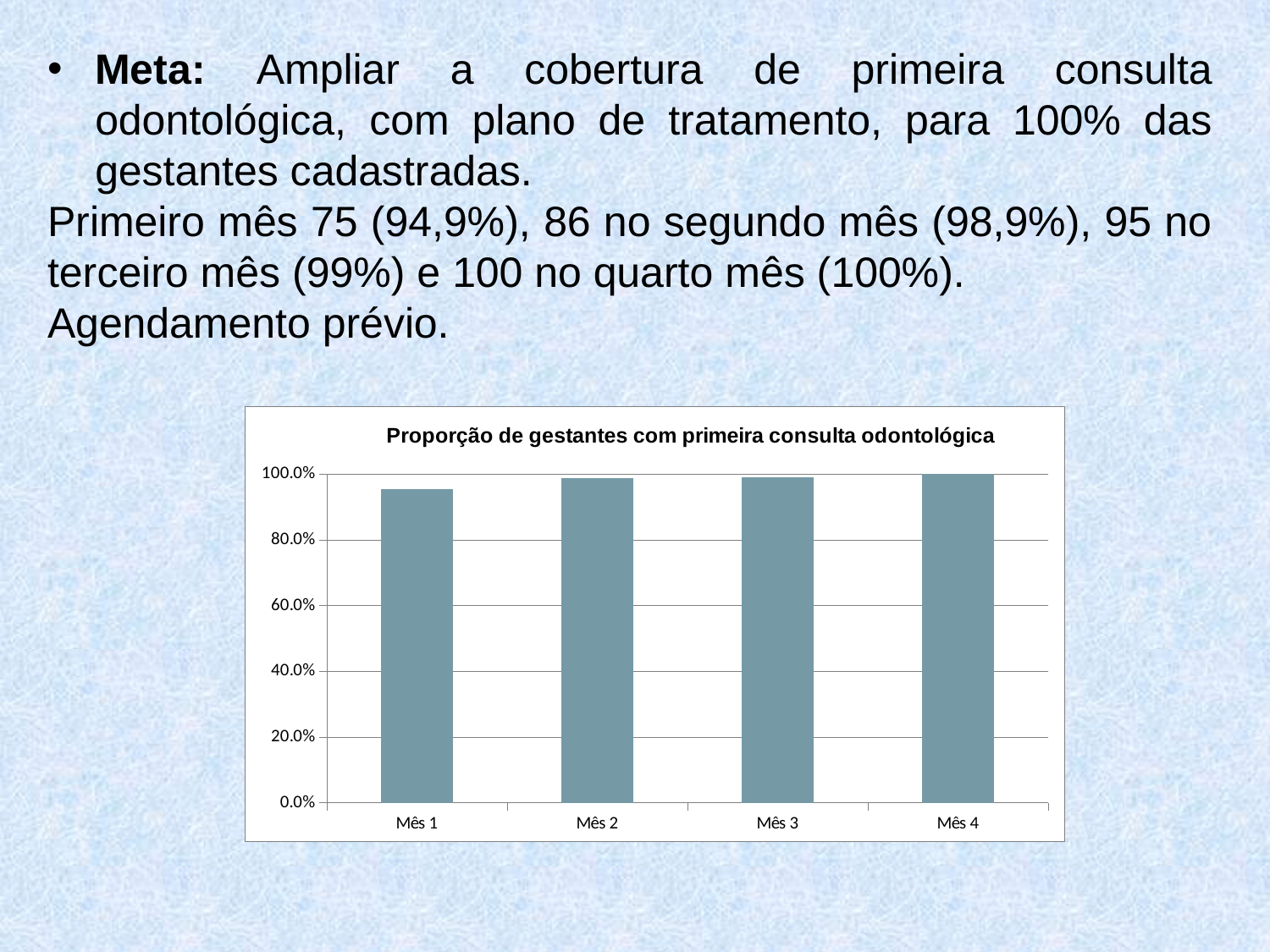
Which is larger, the bar for Mês 1 or the bar for Mês 2? Mês 2 What value does the bar for Mês 4 reach on the y axis? 100.0% What is the title of the chart? Proporção de gestantes com primeira consulta odontológica How many categories (months) are shown on the x axis of the chart? 4 Do the bar values rise or fall from Mês 1 to Mês 4? rise Which month has the lowest bar in the chart? Mês 1 What is the highest value shown on the y axis of the chart? 100.0% What type of chart is shown on the slide? bar chart Is the value for Mês 1 greater or less than 80.0%? greater Is the value for Mês 2 greater or less than 60.0%? greater